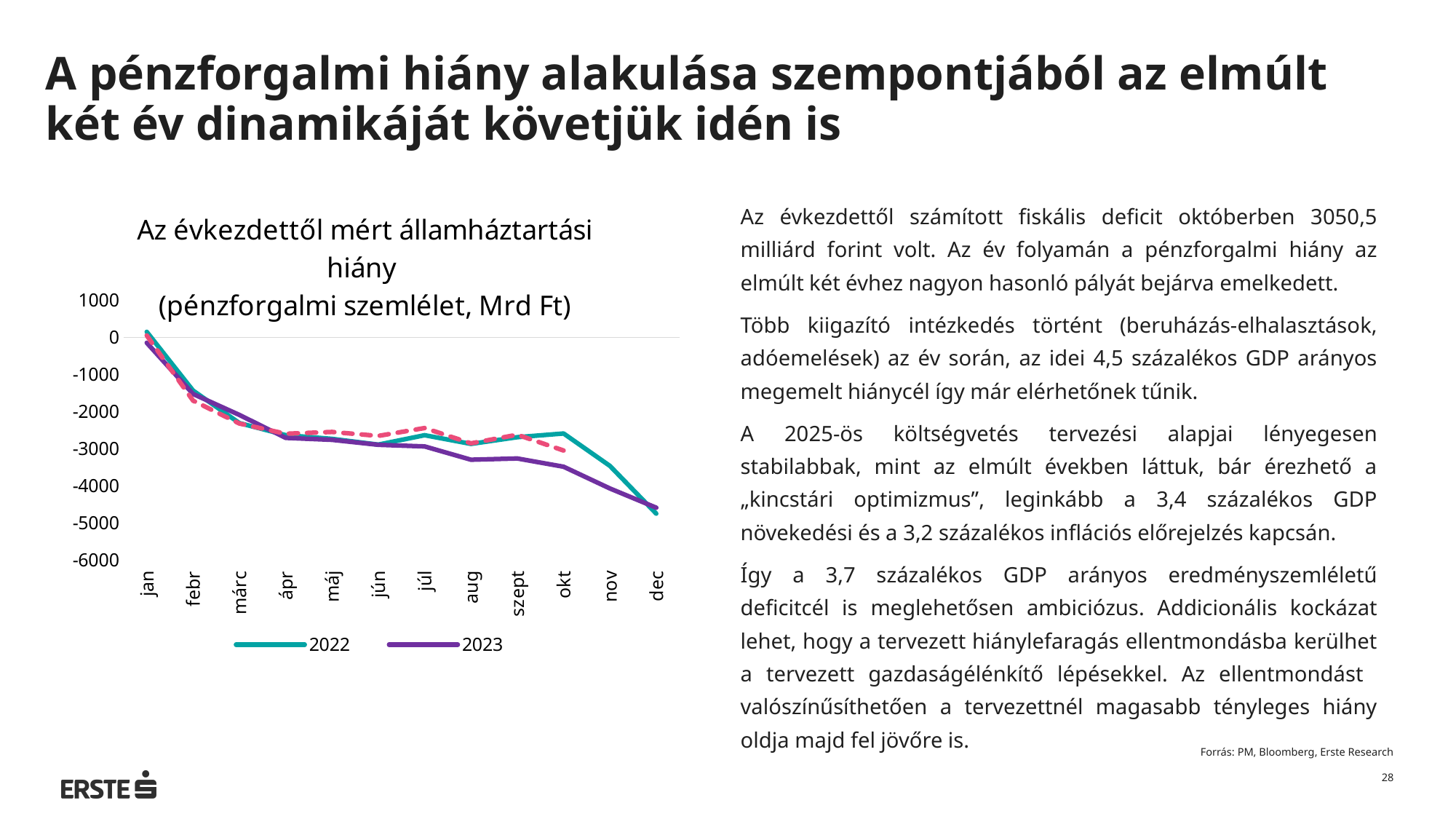
How many months are shown on the x axis of the chart? 12 In okt, which series has the higher value, 2022 or 2023? 2022 Which two series are named in the chart's legend? 2022 and 2023 Is the 2023 value for okt greater or less than -3000? less What is the unit given in the chart title? Mrd Ft Is the 2022 value for dec greater or less than -4000? less What kind of chart is shown on the slide? line chart How many series does the chart's legend list? 2 In which month does the 2022 line reach its highest value? jan Do the values of the 2023 line rise or fall from jan to dec? fall Is the 2022 value for okt greater or less than -3000? greater In which month does the 2023 line reach its lowest value? dec